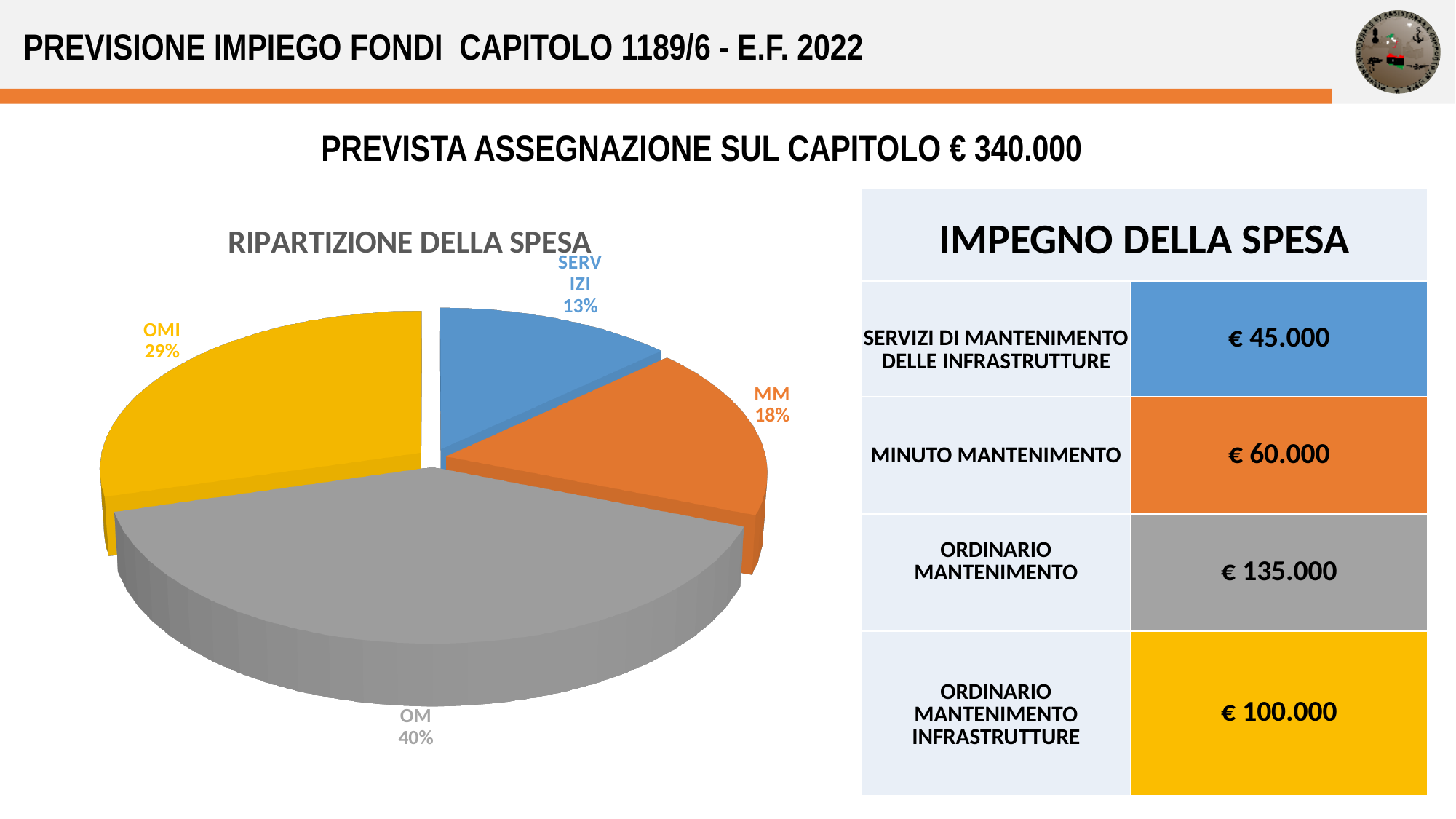
What share of the pie does OM represent? 40% Which is larger in the pie chart, OMI or MM? OMI What is the difference in percentage points between the OM and OMI slices? 11% Which slice of the pie chart is the smallest? SERVIZI What colour is the OM slice in the pie chart? grey What share of the pie does SERVIZI represent? 13% Which slice of the pie chart is the largest? OM What share of the pie does OMI represent? 29% What kind of chart is 'RIPARTIZIONE DELLA SPESA'? pie chart How many slices does the pie chart have? 4 What is the title of the pie chart? RIPARTIZIONE DELLA SPESA